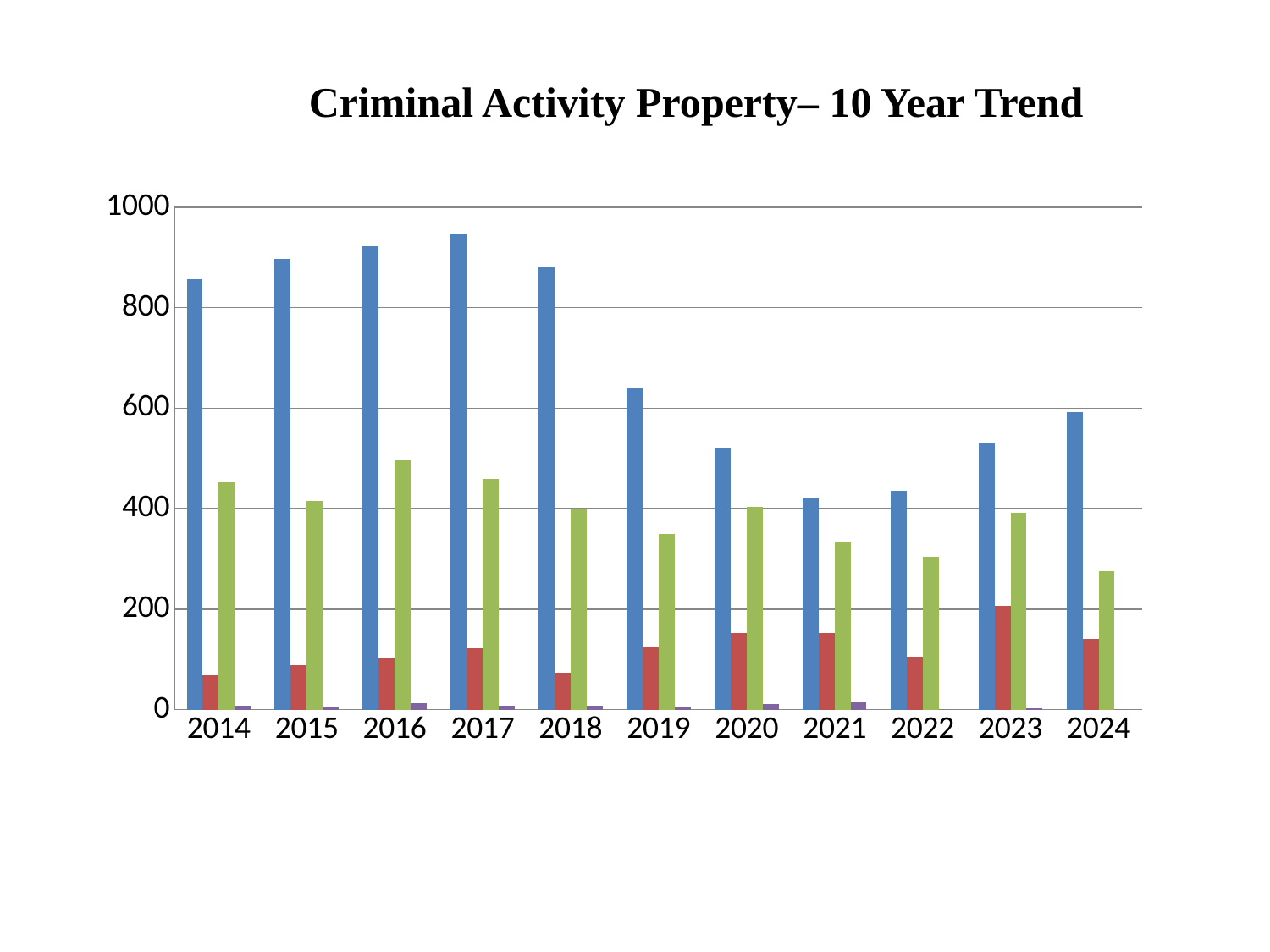
What kind of chart is shown on the slide? Bar chart Which is larger, the blue bar for 2017 or the blue bar for 2018? 2017 In which year is the green bar the shortest? 2024 Do the blue bars rise or fall from 2017 to 2021? Fall In which year is the red bar the tallest? 2023 In which year is the blue bar the tallest? 2017 Is the value of the green bar for 2019 greater or less than 400? less Is the value of the blue bar for 2014 greater or less than 800? greater What is the title of the chart? Criminal Activity Property– 10 Year Trend How many differently coloured bars are plotted for each year? 4 In which year is the green bar the tallest? 2016 How many years are shown on the x axis of the chart? 11